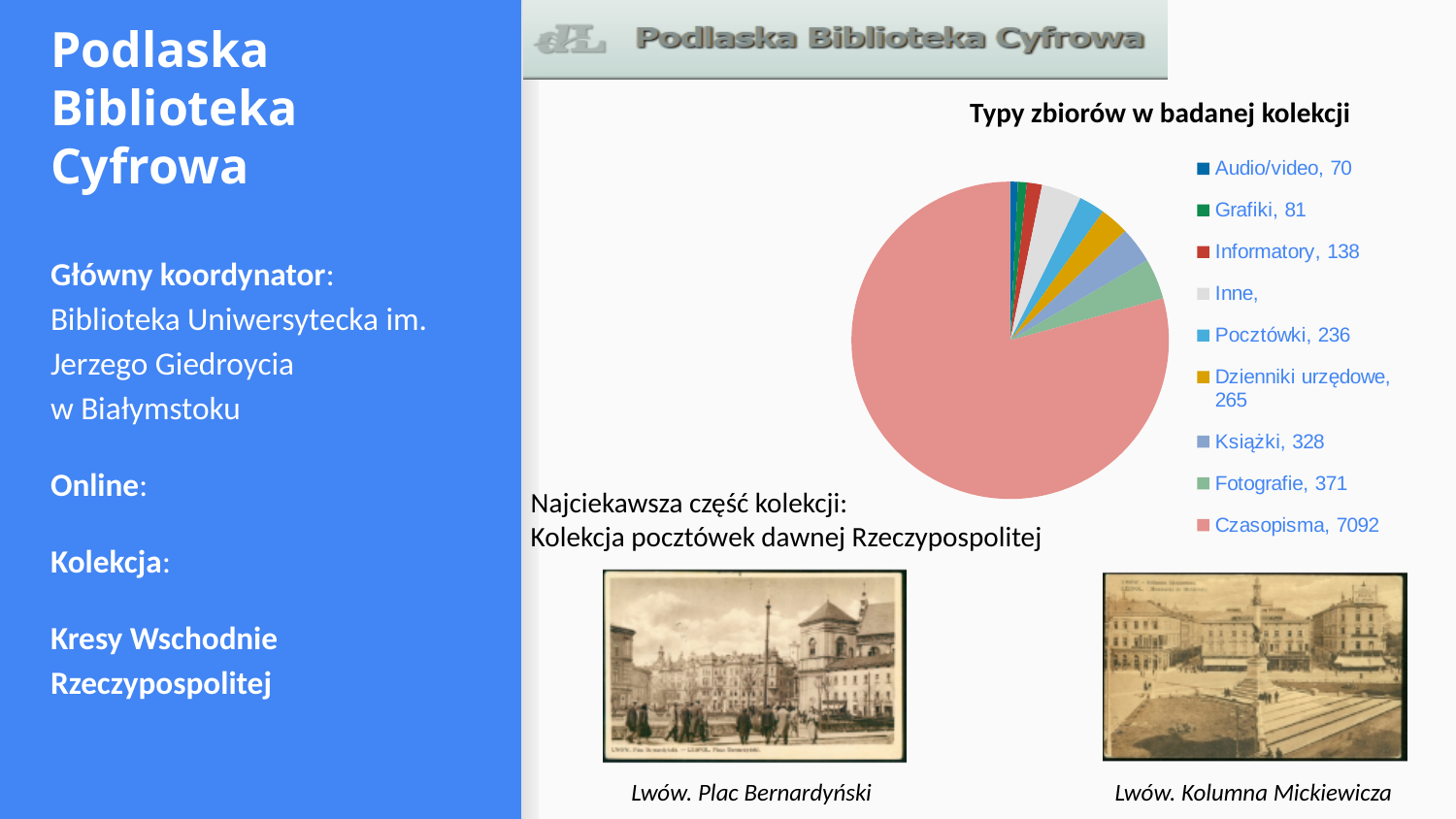
What is the title of the pie chart? Typy zbiorów w badanej kolekcji What kind of chart is shown on the slide? pie chart What is the difference between the values for Fotografie and Książki? 43 Which legend entry in the pie chart has no value printed next to it? Inne Which is larger, the value for Informatory or the value for Grafiki? Informatory Which category has the smallest value among those with a printed value in the legend? Audio/video What is the value for Dzienniki urzędowe in the pie chart? 265 What is the value for Czasopisma in the pie chart? 7092 What is the value for Pocztówki in the pie chart? 236 How many categories does the pie chart's legend list? 9 What is the value for Audio/video in the pie chart? 70 Which category has the largest slice in the pie chart? Czasopisma